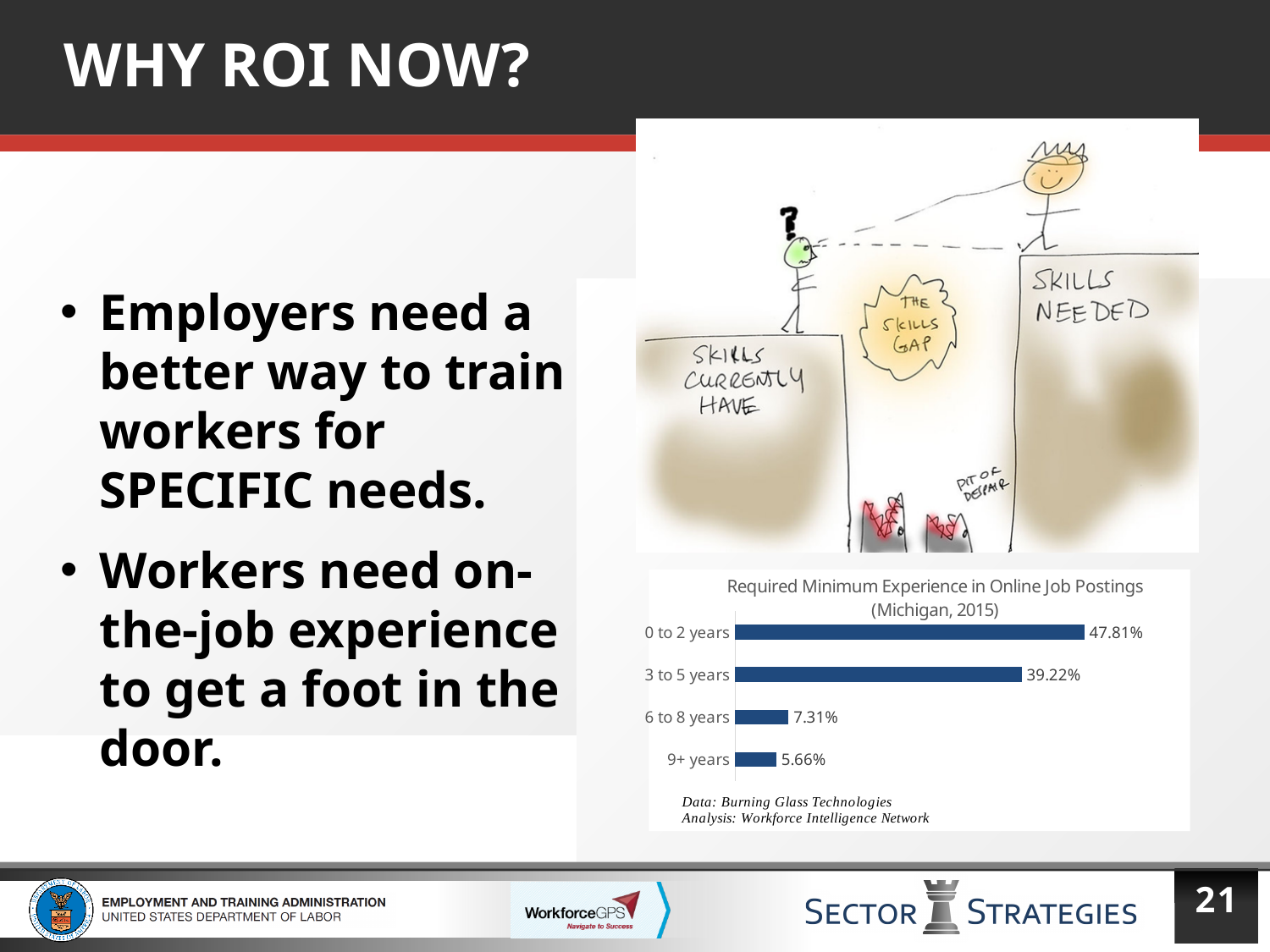
What is the difference between the values for 6 to 8 years and 9+ years? 1.65% What is the title of the chart? Required Minimum Experience in Online Job Postings (Michigan, 2015) How many experience categories are shown in the chart? 4 What is the value for 6 to 8 years? 7.31% Which experience category has the lowest share of online job postings? 9+ years What is the difference between the values for 0 to 2 years and 3 to 5 years? 8.59% What is the value for 3 to 5 years? 39.22% What is the value for 0 to 2 years? 47.81% What is the value for 9+ years? 5.66% Which is larger, the value for 3 to 5 years or the value for 6 to 8 years? 3 to 5 years What kind of chart is shown on the slide? Bar chart Which experience category has the highest share of online job postings? 0 to 2 years